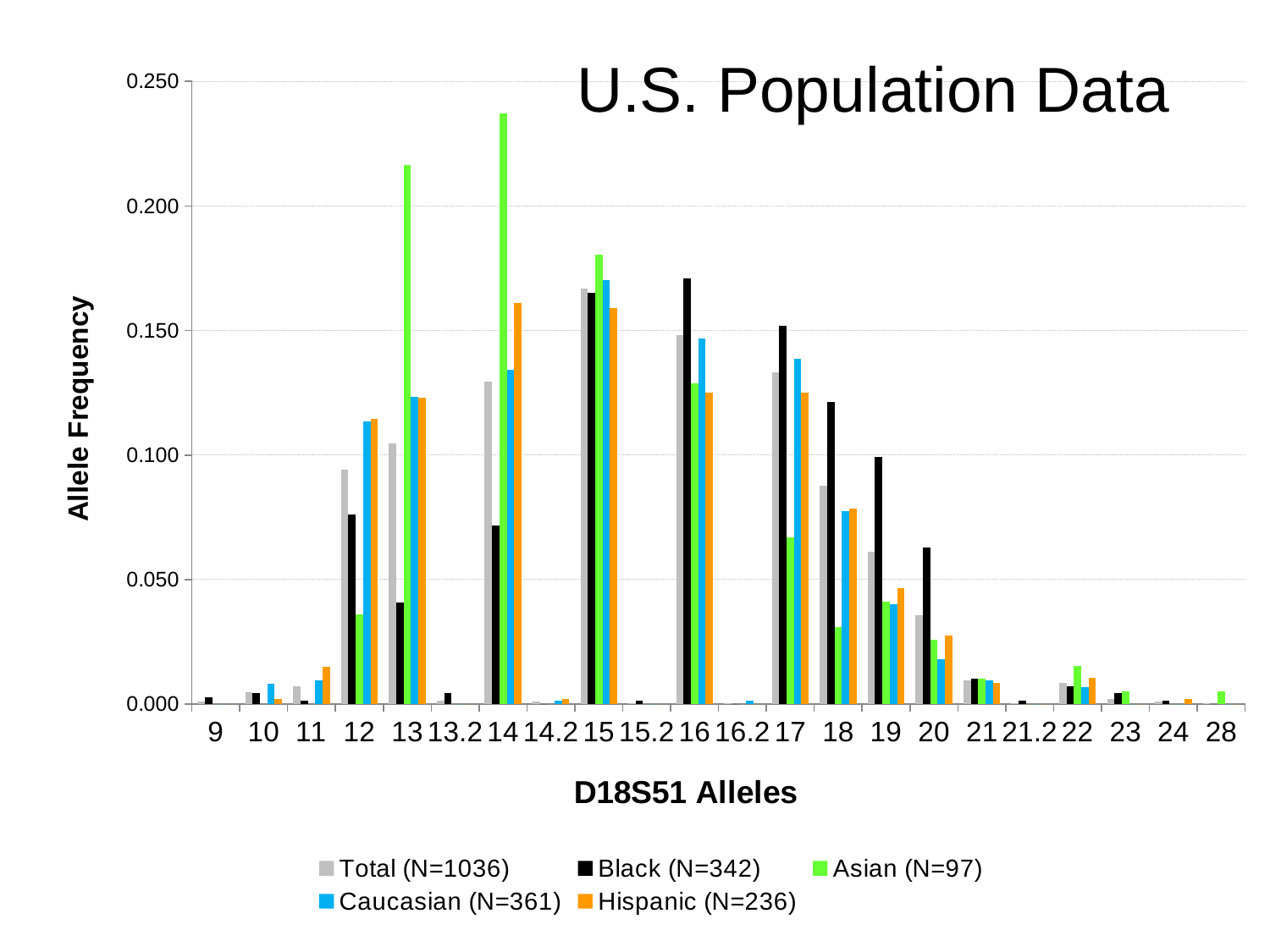
What is the label of the x axis? D18S51 Alleles How many allele categories are shown on the x axis? 22 For which allele is the Total (N=1036) frequency highest? 15 How many series does the legend list? 5 At allele 16, which is larger: the Black (N=342) value or the Caucasian (N=361) value? Black (N=342) Is the Black (N=342) value for allele 13 greater or less than 0.050? less Is the Asian (N=97) value for allele 14 greater or less than 0.200? greater What kind of chart is shown on the slide? bar chart For which allele is the Caucasian (N=361) frequency highest? 15 Is the Caucasian (N=361) value for allele 12 greater or less than 0.100? greater For which allele is the Asian (N=97) frequency highest? 14